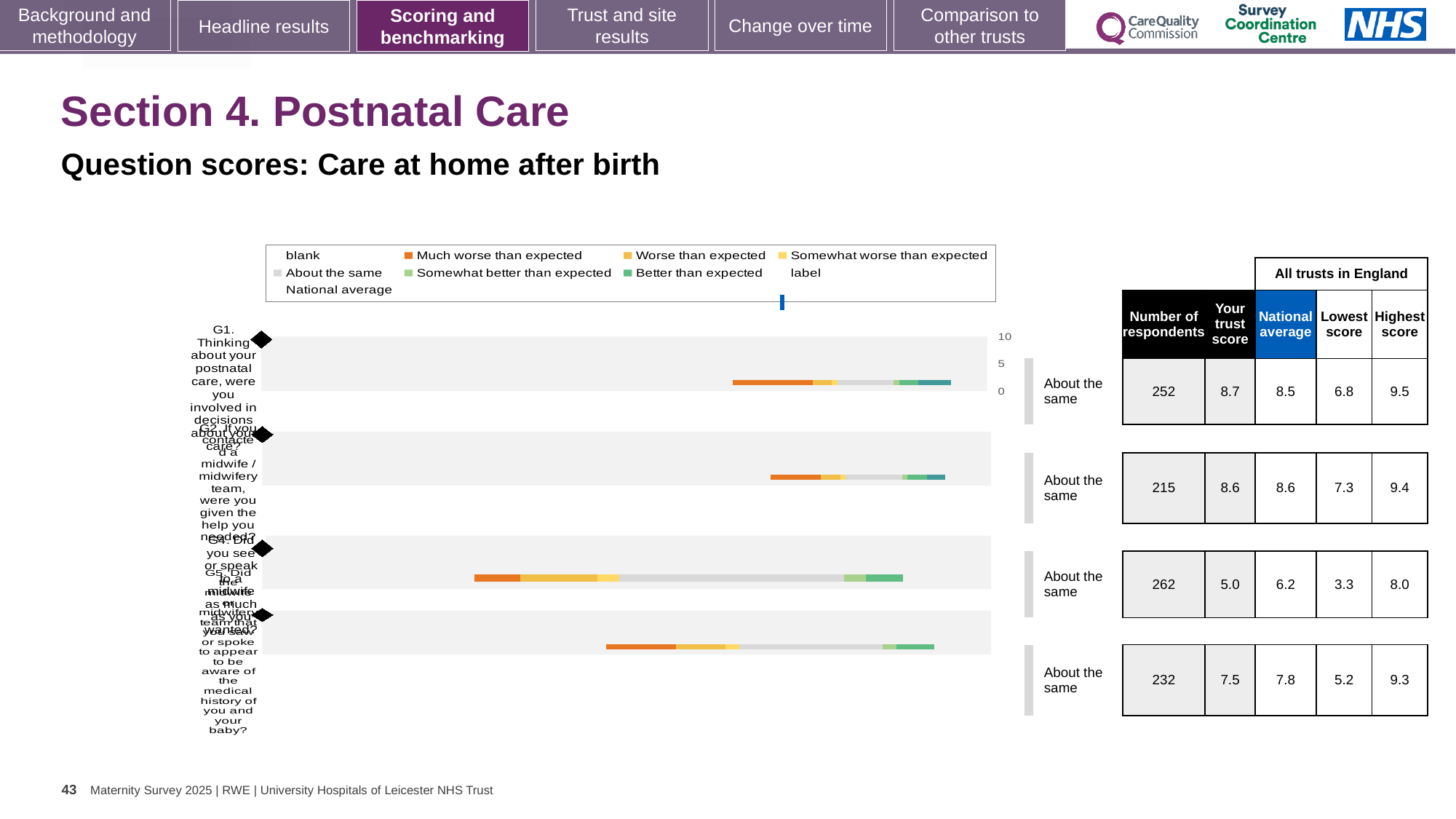
Which row has the highest trust score? the first row (G1), 8.7 What is the number of respondents for the first row (G1, involved in decisions about your care)? 252 What kind of chart is shown on the slide? bar chart What benchmark text is shown beside each of the four bars? About the same How many question bars are plotted in the chart? 4 What is the difference between the highest score and the lowest score for the first row (G1)? 2.7 What is the national average for the first row (G1)? 8.5 Which legend entry is shown in orange? Much worse than expected For the third row, which is larger: the trust score or the national average? the national average (6.2) What is the trust score for the first row (G1)? 8.7 Which row has the lowest trust score? the third row, 5.0 What is the highest score for the second row (G2)? 9.4